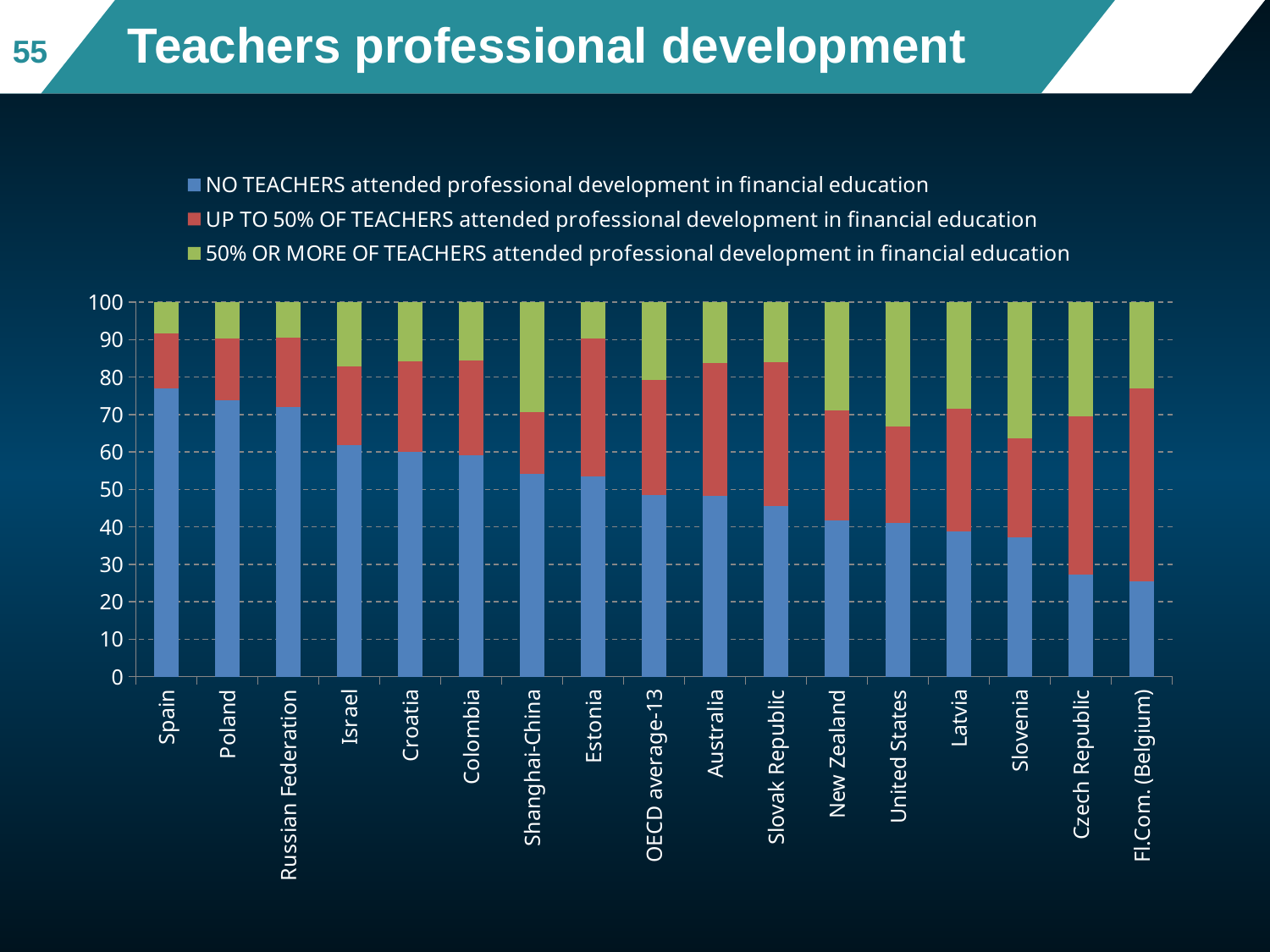
Is the value for Czech Republic in the 'NO TEACHERS attended professional development' series greater or less than 30? less What kind of chart is shown on the slide? Stacked bar chart What colour represents 'NO TEACHERS attended professional development in financial education' in the legend? Blue Which has a larger 'NO TEACHERS attended professional development' value, Israel or Slovenia? Israel How many countries/categories are shown on the x axis? 17 How many series does the legend list? 3 What is the total height of the stacked bar for Spain? 100 Which category has the highest value for 'NO TEACHERS attended professional development in financial education'? Spain Moving from left to right along the x axis, does the 'NO TEACHERS attended professional development' segment generally rise or fall? Fall Is the value for Fl.Com. (Belgium) in the 'NO TEACHERS attended professional development' series greater or less than 30? less Which has a larger 'NO TEACHERS attended professional development' value, Spain or Fl.Com. (Belgium)? Spain Is the value for Spain in the 'NO TEACHERS attended professional development' series greater or less than 70? greater